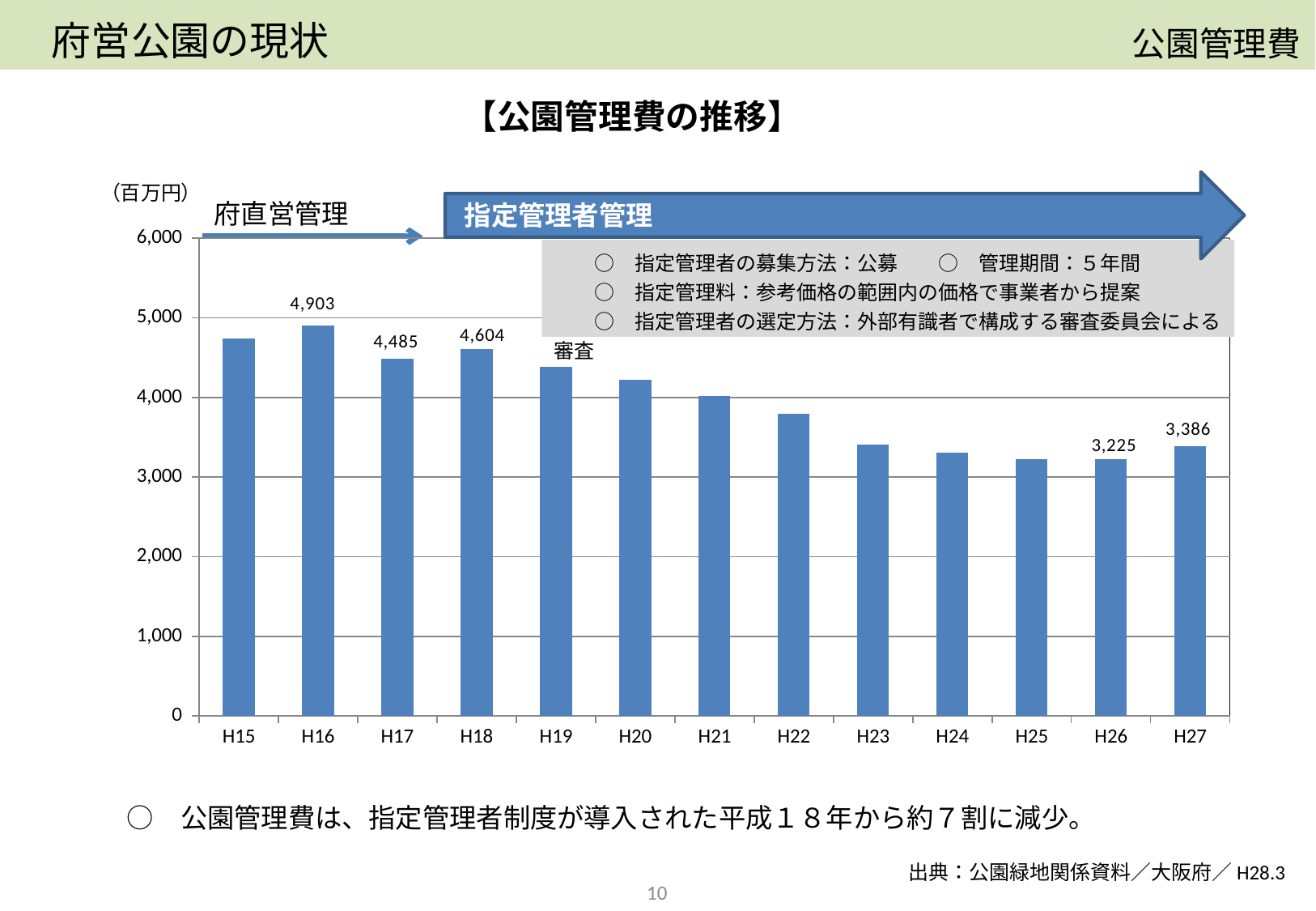
What is the difference between the values for H18 and H27? 1,218 How many years are shown on the x axis? 13 What is the difference between the values for H16 and H17? 418 Is the value for H15 greater or less than 4,000? greater Do the values generally rise or fall from H16 to H27? fall What is the value for H16? 4,903 What is the value for H27? 3,386 Which is larger, the value for H17 or the value for H18? H18 What is the value for H18? 4,604 Which year has the highest value? H16 Is the value for H22 greater or less than 4,000? less What kind of chart is shown on the slide? bar chart